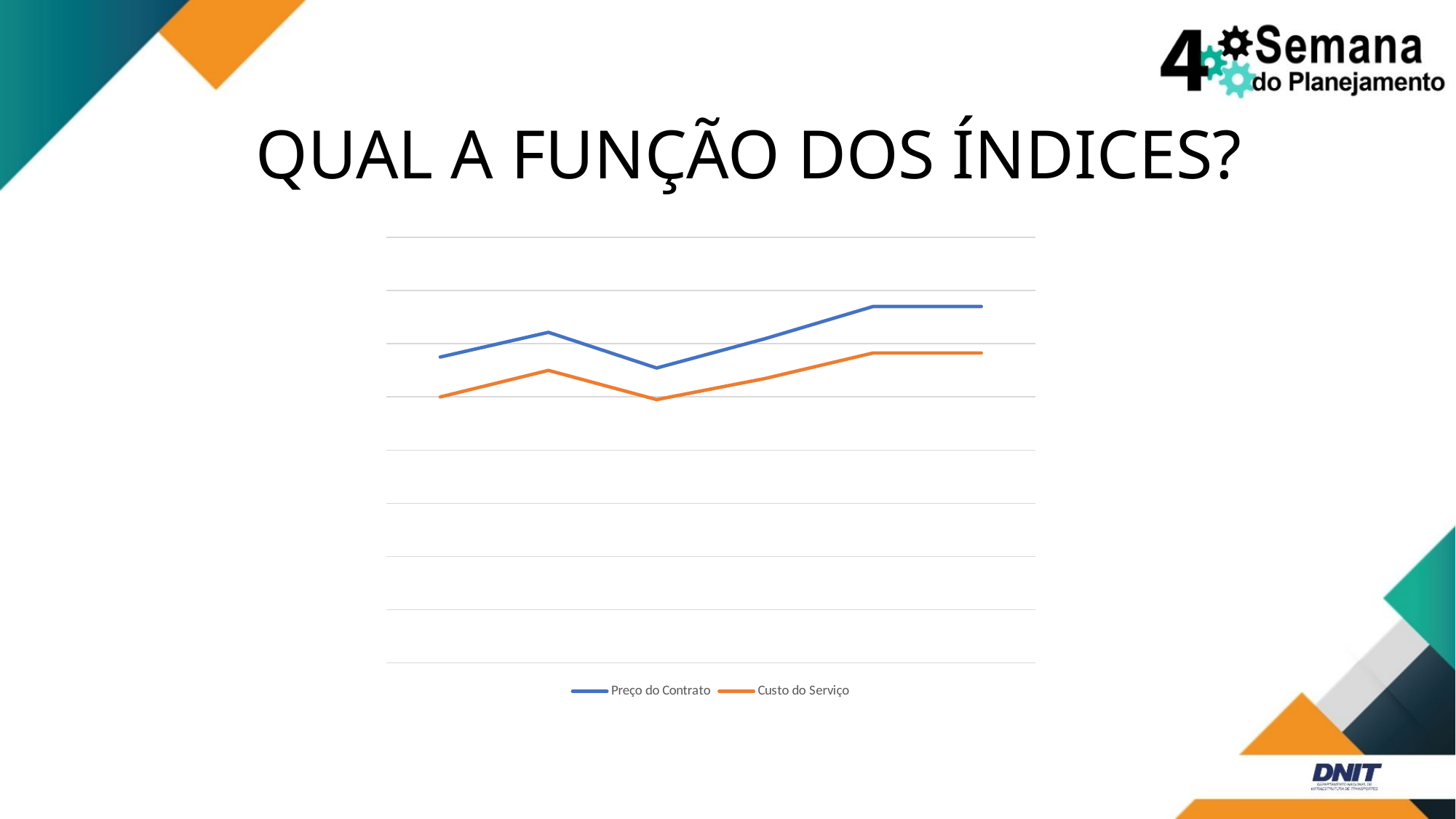
Which series has the lowest point on the chart? Custo do Serviço How many series does the legend list? 2 What are the two series named in the legend? Preço do Contrato and Custo do Serviço Is the last point of Preço do Contrato higher or lower than its first point? higher Does Preço do Contrato rise or fall between its second and third points? fall What colour is the line for Custo do Serviço? orange What kind of chart is shown on the slide? line chart Which series lies above the other across the whole chart? Preço do Contrato Which series is higher at the last data point, Preço do Contrato or Custo do Serviço? Preço do Contrato Is the last point of Custo do Serviço higher or lower than its first point? higher